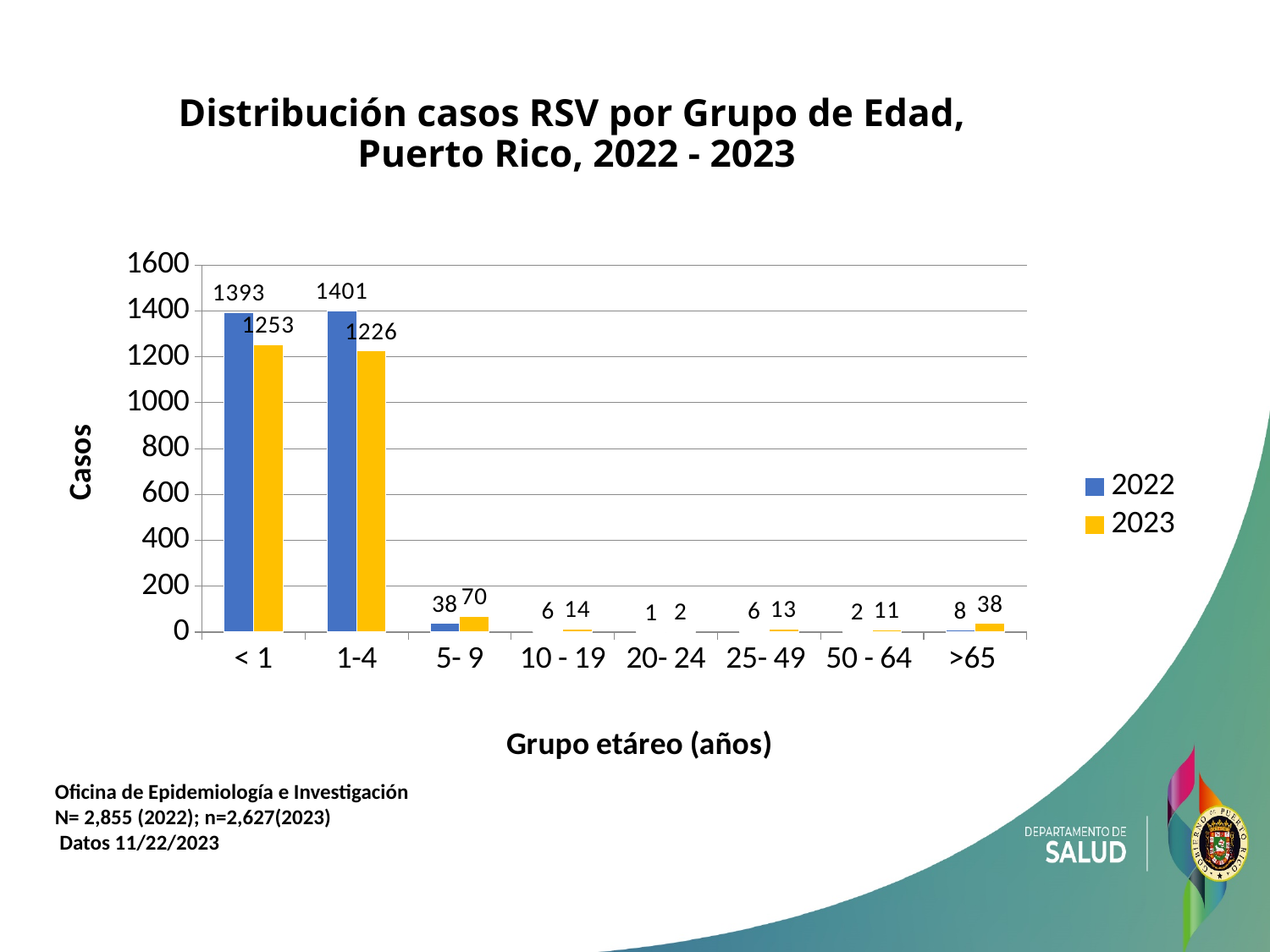
Which age group has the lowest number of cases in 2023? 20- 24 What is the difference between the 2022 and 2023 values for the < 1 age group? 140 Which is larger for the 10 - 19 age group, the 2022 value or the 2023 value? 2023 What is the number of cases for the 1-4 age group in 2023? 1226 How many series does the legend list? 2 What is the label of the y axis? Casos What is the number of cases for the < 1 age group in 2022? 1393 What is the number of cases for the >65 age group in 2022? 8 What is the number of cases for the 5- 9 age group in 2023? 70 Which age group has the highest number of cases in 2022? 1-4 How many age groups are shown on the x axis? 8 What kind of chart is shown on the slide? Bar chart